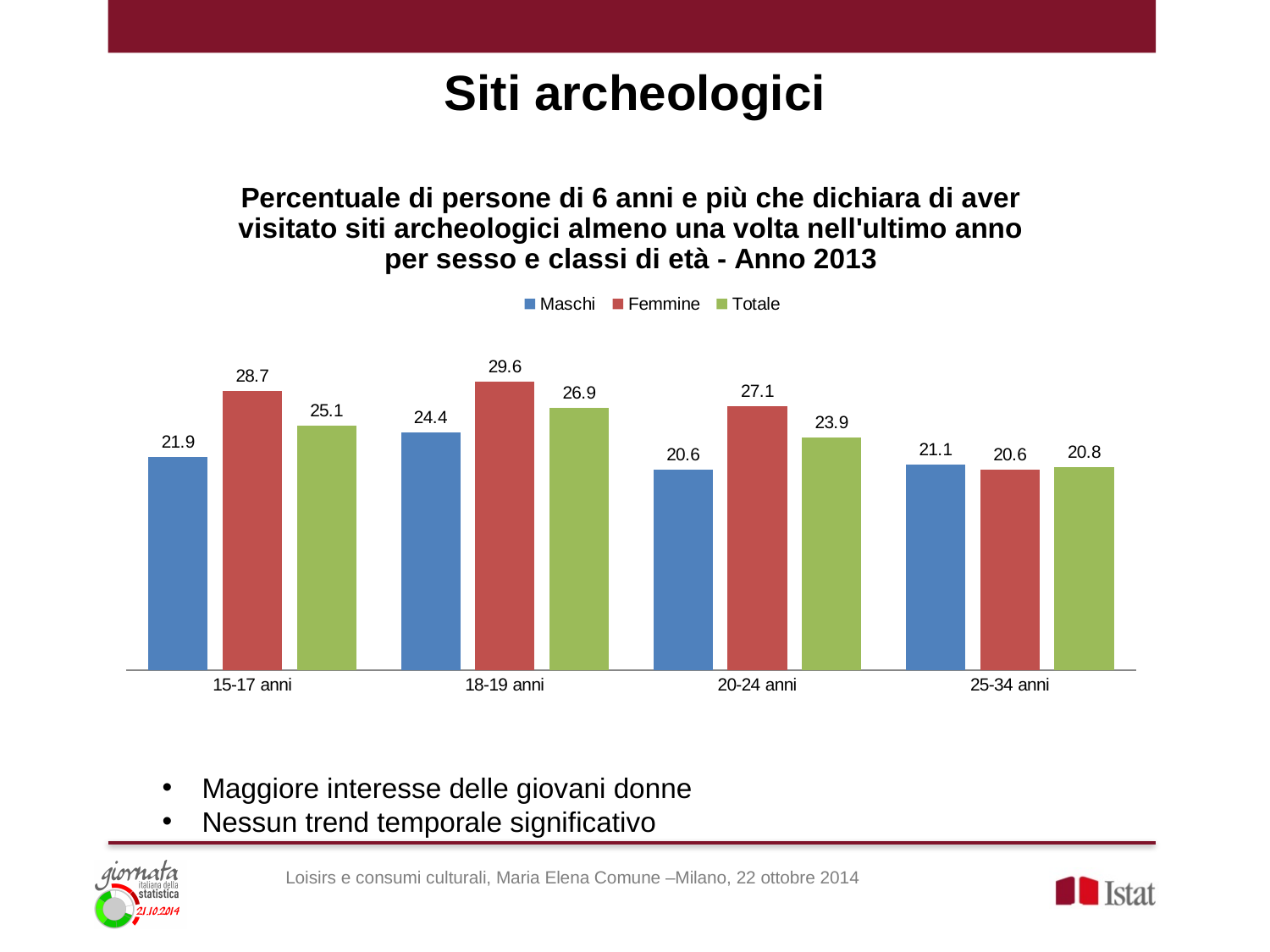
What is the value for Femmine in the 18-19 anni age group? 29.6 What kind of chart is shown on the slide? Bar chart Does the Totale value rise or fall from 18-19 anni to 25-34 anni? Fall What is the difference between the Femmine and Maschi values for the 15-17 anni age group? 6.8 What is the value for Maschi in the 20-24 anni age group? 20.6 Which series is shown in green in the legend? Totale How many age groups are shown on the x axis? 4 Which age group has the lowest Totale value? 25-34 anni Which is larger in the 20-24 anni age group, the Maschi value or the Femmine value? Femmine Which age group has the highest Femmine value? 18-19 anni How many series does the legend list? 3 What is the Totale value for the 25-34 anni age group? 20.8